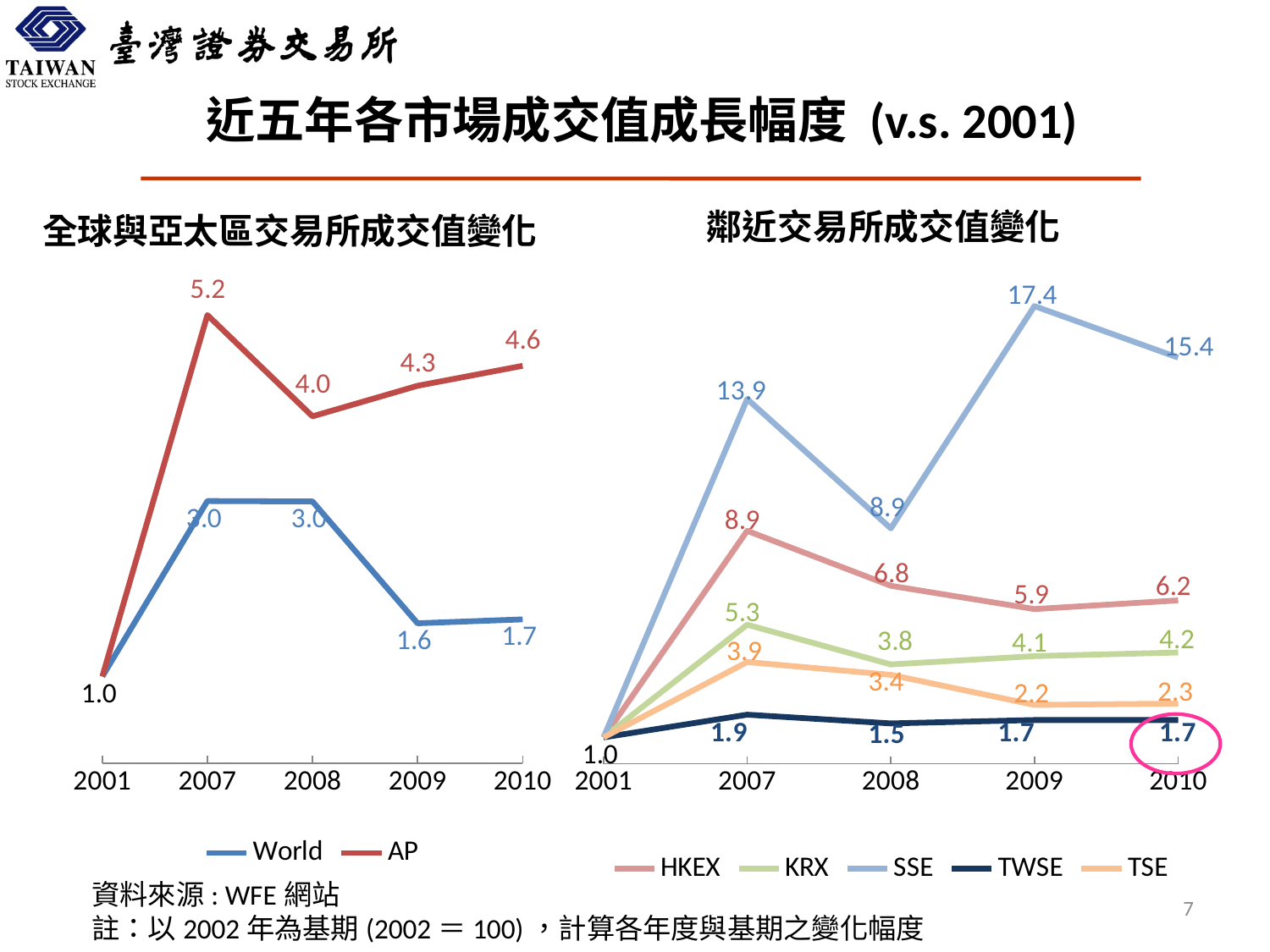
In the right chart (鄰近交易所成交值變化), how many series does the legend list? 5 In the left chart (全球與亞太區交易所成交值變化), in which year does AP reach its highest value? 2007 In the left chart (全球與亞太區交易所成交值變化), what is the value for AP in 2007? 5.2 In the right chart (鄰近交易所成交值變化), which is larger in 2007, HKEX or KRX? HKEX In the left chart (全球與亞太區交易所成交值變化), how many series does the legend list? 2 What kind of chart is the right chart (鄰近交易所成交值變化)? Line chart In the right chart (鄰近交易所成交值變化), what is the difference between SSE and HKEX in 2010? 9.2 In the right chart (鄰近交易所成交值變化), what is the value for TWSE in 2008? 1.5 In the left chart (全球與亞太區交易所成交值變化), what is the value for World in 2009? 1.6 In the left chart (全球與亞太區交易所成交值變化), what is the difference between AP and World in 2010? 2.9 In the right chart (鄰近交易所成交值變化), what is the value for SSE in 2009? 17.4 In the right chart (鄰近交易所成交值變化), which series has the lowest value in 2010? TWSE